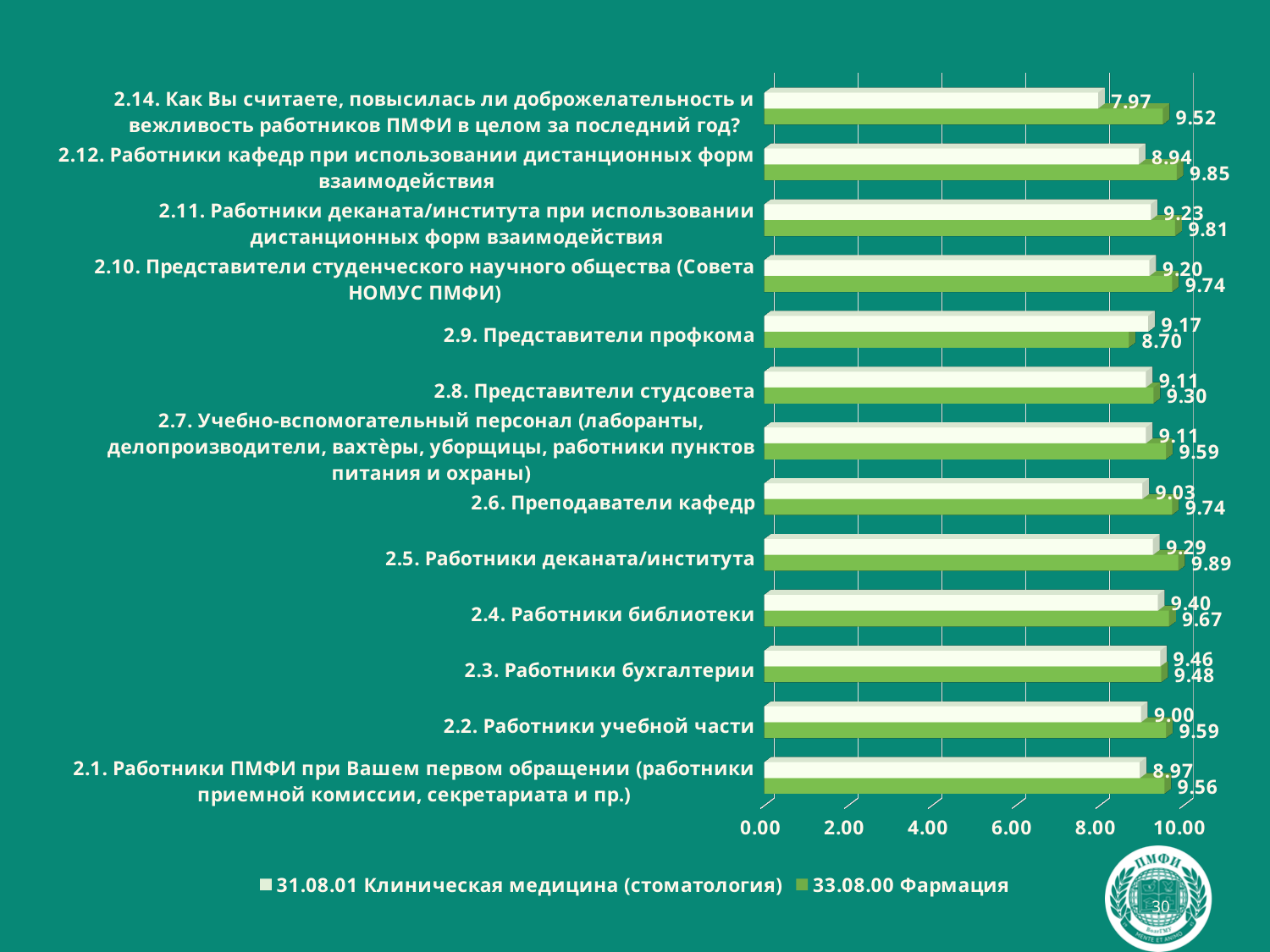
How many categories are shown on the chart? 13 How many series does the legend list? 2 Which category has the lowest value for 33.08.00 Фармация? 2.9. Представители профкома What kind of chart is shown on the slide? Bar chart What is the value for 33.08.00 Фармация for category 2.9. Представители профкома? 8.70 For 2.9. Представители профкома, which series has the larger value: 31.08.01 Клиническая медицина (стоматология) or 33.08.00 Фармация? 31.08.01 Клиническая медицина (стоматология) Which category has the lowest value for 31.08.01 Клиническая медицина (стоматология)? 2.14. Как Вы считаете, повысилась ли доброжелательность и вежливость работников ПМФИ в целом за последний год? What is the value for 33.08.00 Фармация for category 2.12. Работники кафедр при использовании дистанционных форм взаимодействия? 9.85 Is the value for 31.08.01 Клиническая медицина (стоматология) for 2.14. Как Вы считаете, повысилась ли доброжелательность и вежливость работников ПМФИ в целом за последний год? greater or less than 8.00? less Which category has the highest value for 33.08.00 Фармация? 2.5. Работники деканата/института What is the difference between the 33.08.00 Фармация and 31.08.01 Клиническая медицина (стоматология) values for 2.14. Как Вы считаете, повысилась ли доброжелательность и вежливость работников ПМФИ в целом за последний год? 1.55 What is the value for 31.08.01 Клиническая медицина (стоматология) for category 2.14. Как Вы считаете, повысилась ли доброжелательность и вежливость работников ПМФИ в целом за последний год? 7.97